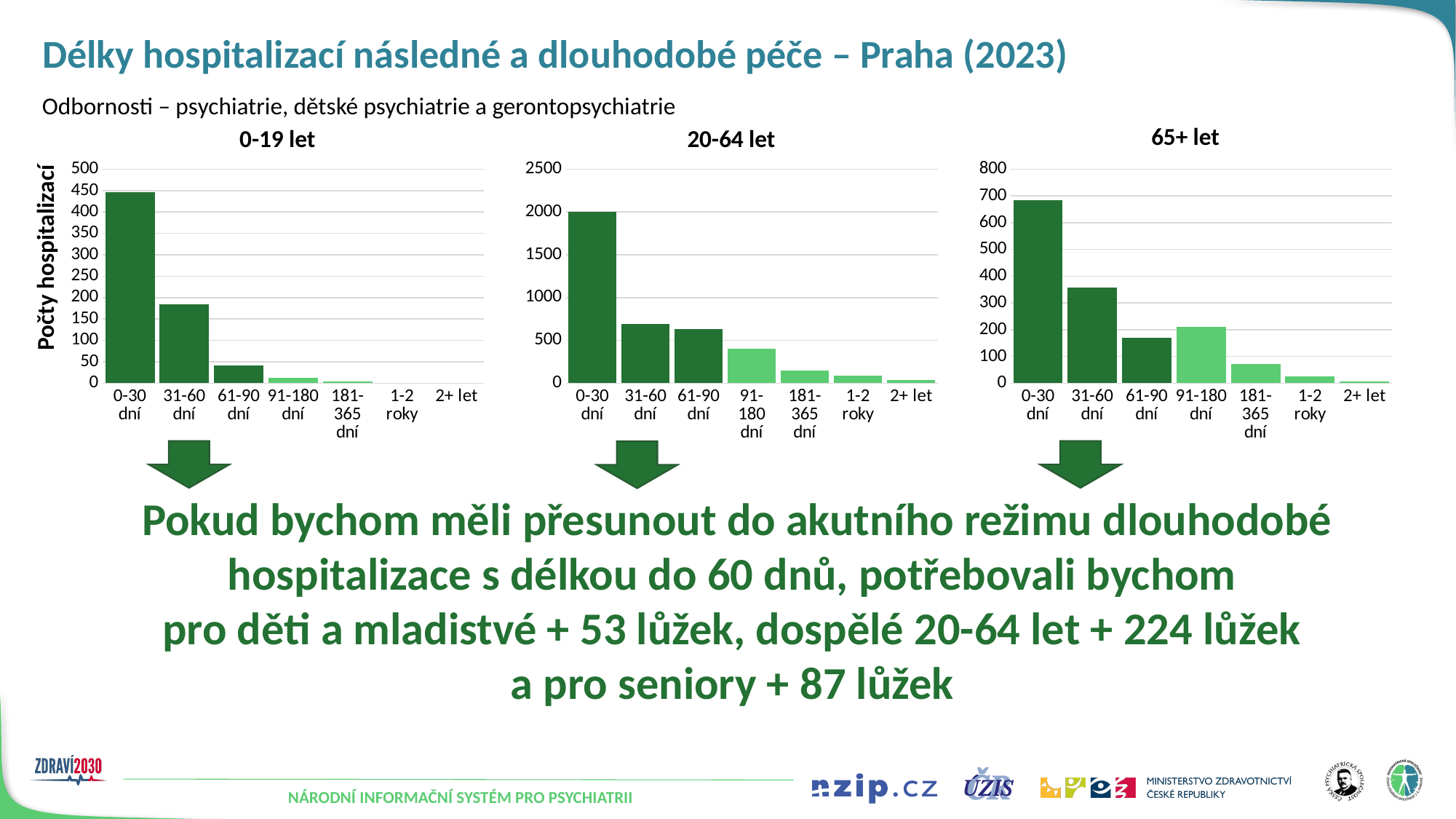
How many charts are shown on the slide? 3 In the "65+ let" chart, is the value for 31-60 dní greater or less than 300? greater In the "65+ let" chart, which category has the highest number of hospitalizations? 0-30 dní What is the label on the vertical axis of the "0-19 let" chart? Počty hospitalizací In the "20-64 let" chart, how many length-of-stay categories are shown on the x axis? 7 In the "20-64 let" chart, is the value for 91-180 dní greater or less than 500? less In the "65+ let" chart, which is larger: the value for 61-90 dní or the value for 91-180 dní? 91-180 dní In the "0-19 let" chart, is the value for 0-30 dní greater or less than 400? greater What kind of chart is the "0-19 let" chart? bar chart In the "0-19 let" chart, do the values rise or fall as you move from left to right along the x axis? fall In the "20-64 let" chart, which is larger: the value for 31-60 dní or the value for 91-180 dní? 31-60 dní